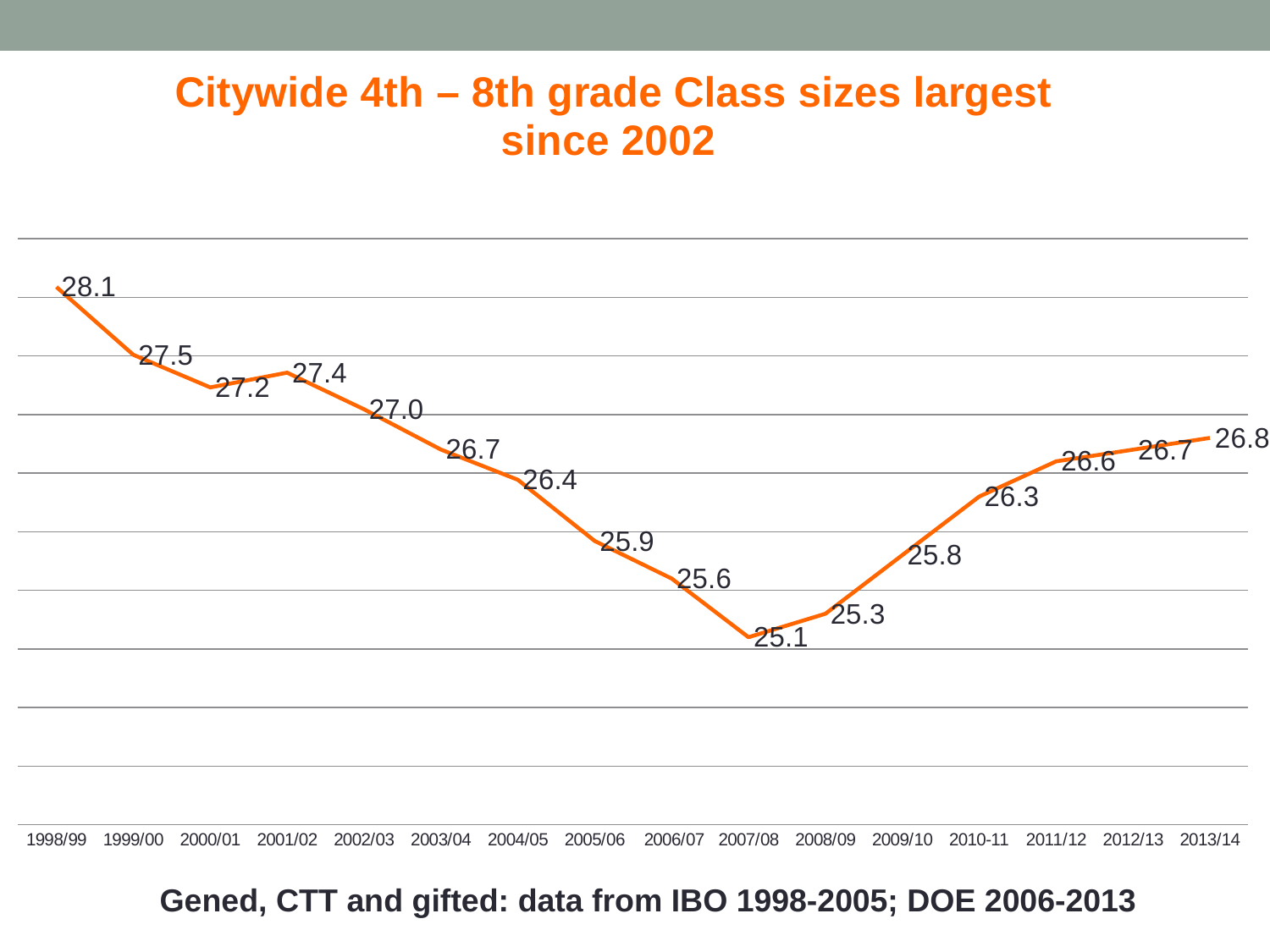
What is the class size value for 2003/04? 26.7 What is the class size value for 2007/08? 25.1 Which is larger, the class size in 2001/02 or in 2011/12? 2001/02 What is the difference between the class size in 2013/14 and in 2007/08? 1.7 Which school year has the highest class size value? 1998/99 What is the class size value for 2013/14? 26.8 What kind of chart is shown on the slide? Line chart What is the class size value for 1998/99? 28.1 How many school years are plotted on the chart? 16 Do the class size values rise or fall from 2007/08 to 2013/14? Rise What is the difference between the class size in 1998/99 and in 2007/08? 3.0 Which school year has the lowest class size value? 2007/08